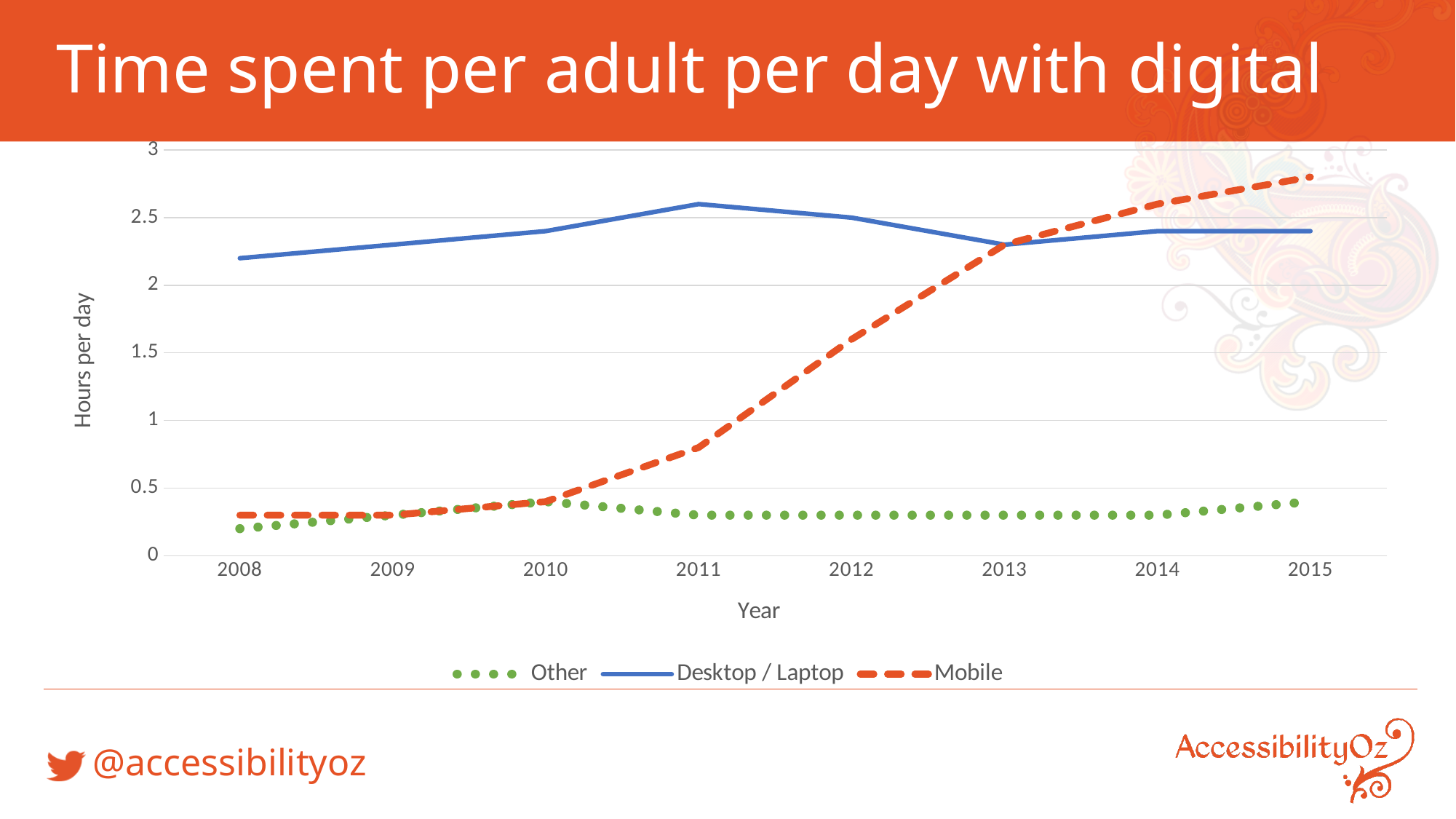
Is the Desktop / Laptop value for 2008 greater or less than 2? greater How many years are plotted along the x axis? 8 Is the Mobile value for 2011 greater or less than 1? less How many series does the legend list? 3 Which series has the highest value in 2015? Mobile What is the label on the vertical axis? Hours per day What kind of chart is shown on the slide? line chart Is the Mobile value for 2015 greater or less than 2.5? greater In which year does the Desktop / Laptop series reach its highest value? 2011 Does the Mobile series rise or fall from 2008 to 2015? rise In 2011, which is larger: Desktop / Laptop or Mobile? Desktop / Laptop